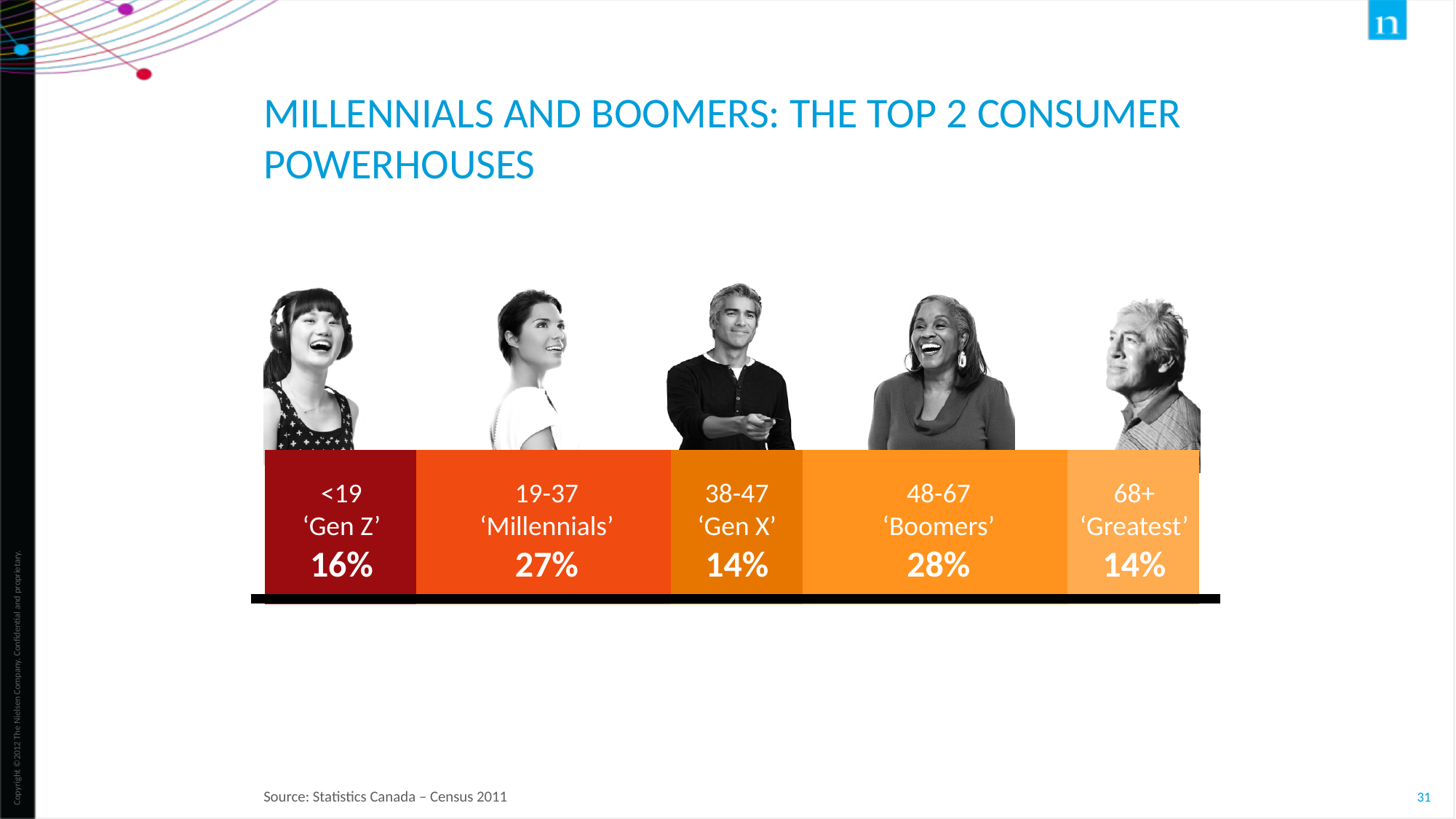
How many generation segments are shown in the bar? 5 Which two generation segments share the lowest percentage? 'Gen X' and 'Greatest' What age range is labelled for the 'Greatest' segment? 68+ What percentage is shown for 'Millennials' (19-37)? 27% What kind of chart is shown on the slide? Bar chart What is the difference in percentage points between 'Boomers' and 'Gen Z'? 12 What percentage is shown for 'Gen X' (38-47)? 14% Which has a larger percentage, 'Millennials' or 'Gen Z'? 'Millennials' What percentage is shown for 'Gen Z' (<19)? 16% What percentage is shown for 'Boomers' (48-67)? 28% What is the difference in percentage points between 'Millennials' and 'Gen X'? 13 Which generation segment has the highest percentage? 'Boomers'